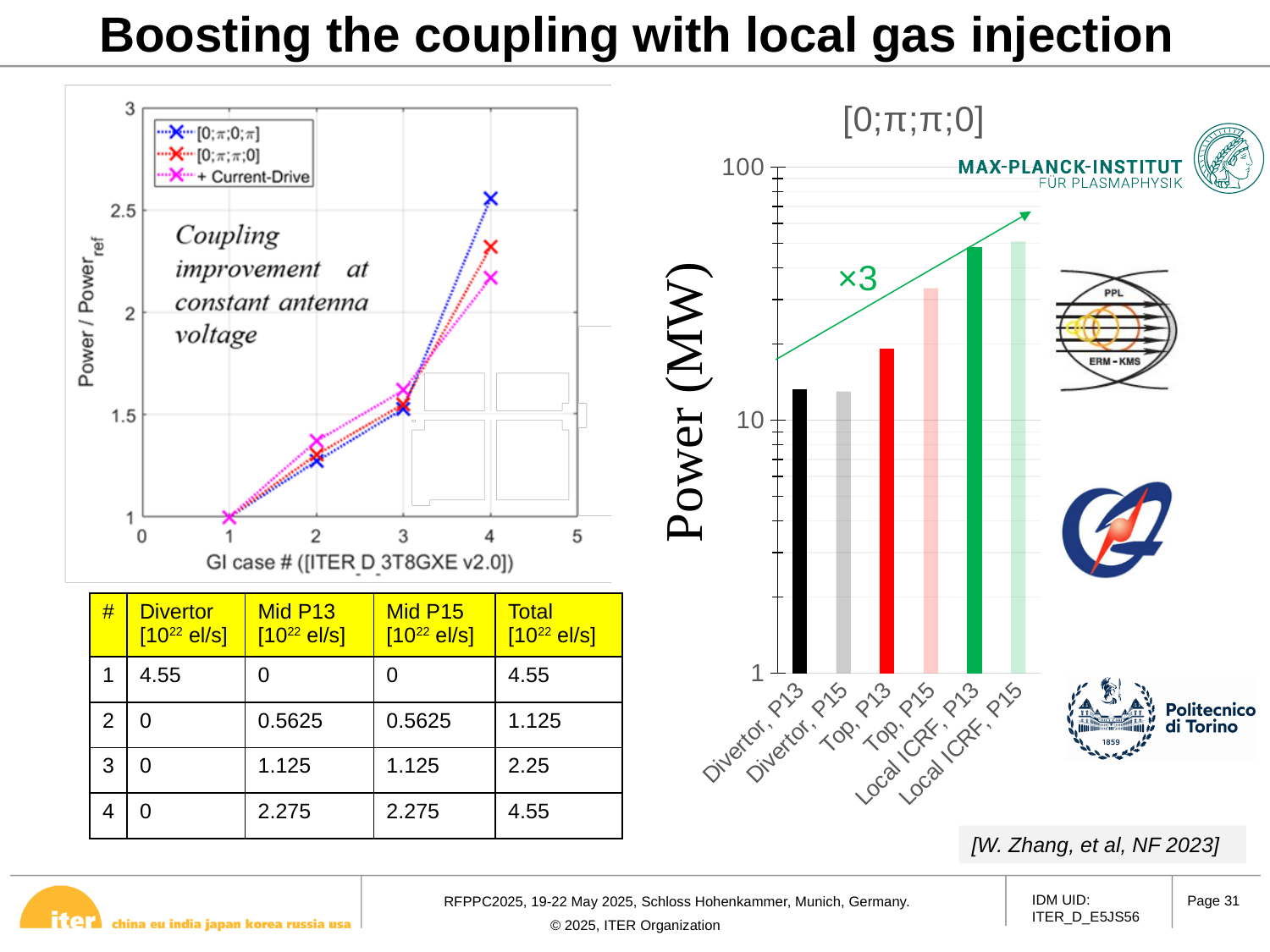
In the right-hand bar chart titled [0;π;π;0], is the value for Divertor, P13 greater or less than 10? greater In the left-hand line chart, what is the Power / Power_ref value at GI case # 1? 1 In the right-hand bar chart titled [0;π;π;0], is the value for Local ICRF, P13 greater or less than 100? less What kind of chart is the left-hand chart with Power / Power_ref on the y axis? line chart In the right-hand bar chart titled [0;π;π;0], how many bars (categories) are shown? 6 In the right-hand bar chart titled [0;π;π;0], which is larger: Local ICRF, P13 or Divertor, P13? Local ICRF, P13 In the right-hand bar chart titled [0;π;π;0], do the bar values generally rise or fall from left to right? rise In the left-hand line chart, which series has the highest value at GI case # 4? [0;π;0;π] In the right-hand bar chart titled [0;π;π;0], which is larger: Top, P15 or Top, P13? Top, P15 What kind of chart is the right-hand chart titled [0;π;π;0]? bar chart How many series does the legend of the left-hand line chart list? 3 What is the y-axis label of the right-hand bar chart titled [0;π;π;0]? Power (MW)